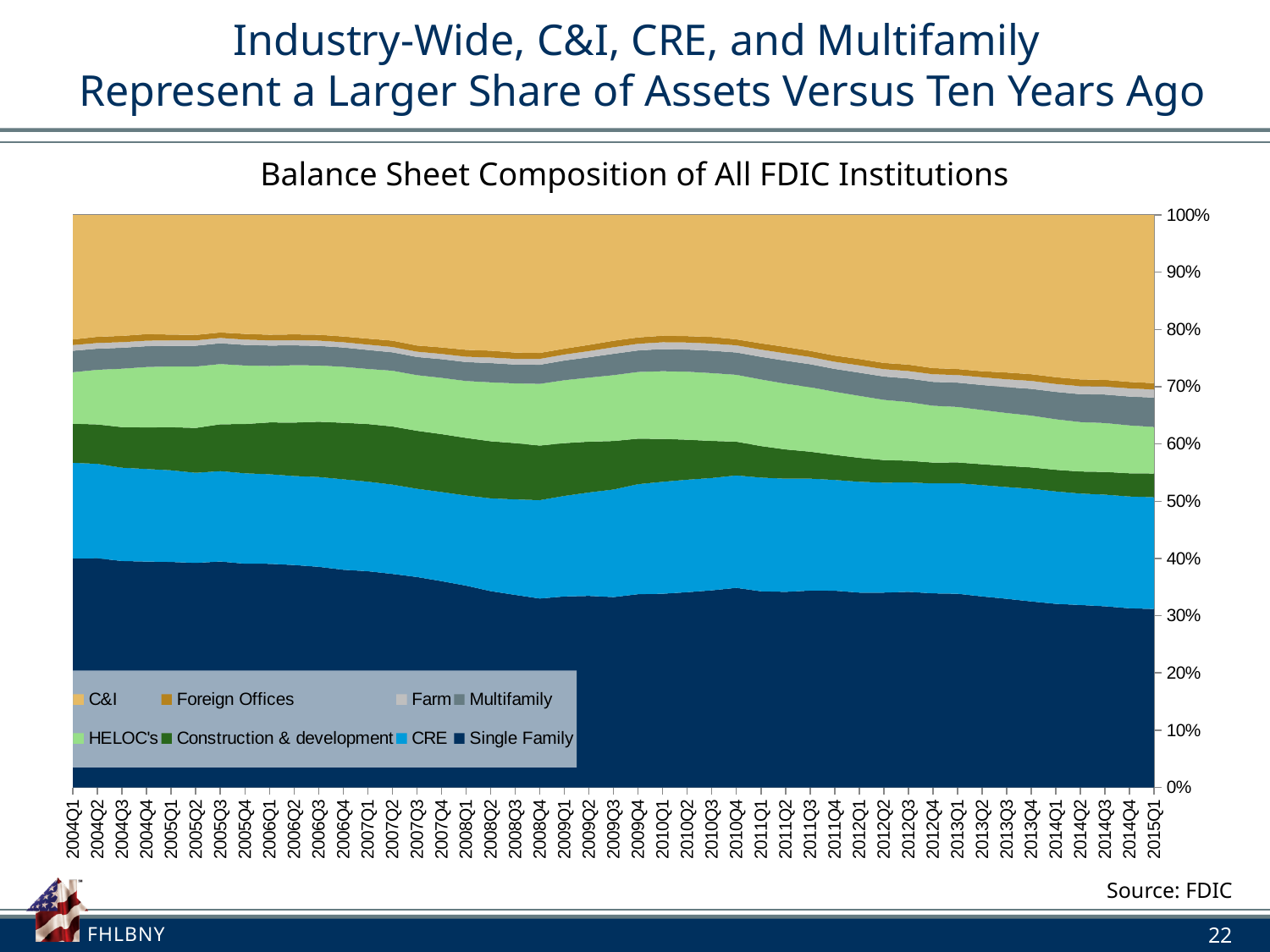
In 2015Q1, which is larger: the Single Family share or the CRE share? Single Family What is the first quarter shown on the x axis? 2004Q1 Does the C&I share rise or fall from 2004Q1 to 2015Q1? Rise How many quarters are plotted along the x axis? 45 What kind of chart is shown on the slide? Stacked area chart What is the last quarter shown on the x axis? 2015Q1 Is the Single Family share in 2004Q1 greater or less than 30%? greater Does the Single Family share rise or fall from 2004Q1 to 2015Q1? Fall In 2004Q1, which is larger: the Single Family share or the CRE share? Single Family Is the Single Family share in 2015Q1 greater or less than 40%? less How many series does the legend list? 8